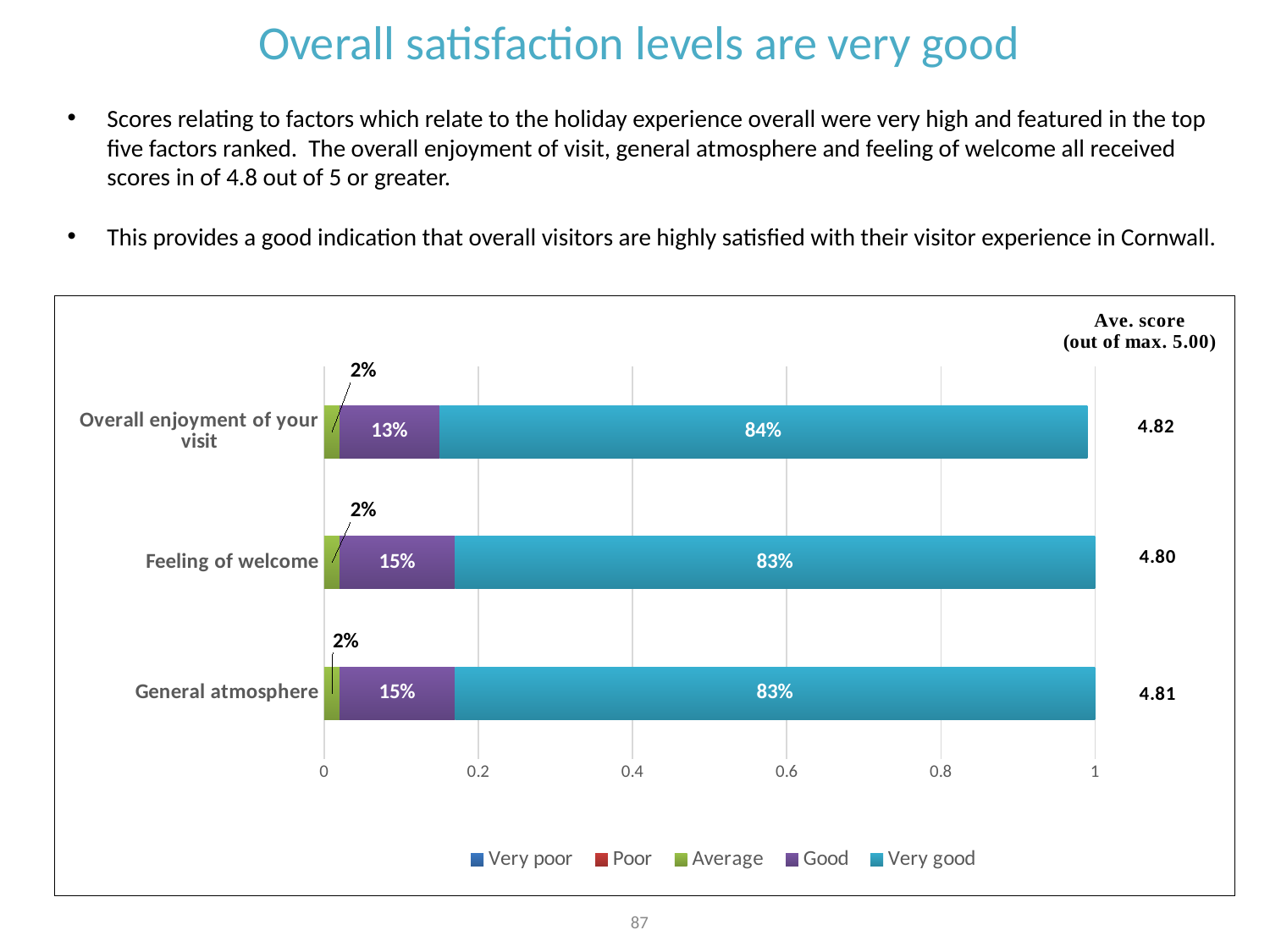
How many series does the legend list? 5 For 'Overall enjoyment of your visit', what is the difference between the Very good and Good percentages? 71 percentage points What percentage of visitors rated 'Feeling of welcome' as Good? 15% What percentage of visitors rated 'Overall enjoyment of your visit' as Very good? 84% Which category has the lowest Good percentage? Overall enjoyment of your visit What percentage of visitors rated 'General atmosphere' as Average? 2% What kind of chart is shown on the slide? Stacked bar chart How many categories are shown on the chart? 3 What is the total of the labelled segments (Average, Good, Very good) for 'Overall enjoyment of your visit'? 99% Which category has the highest Very good percentage? Overall enjoyment of your visit What is the average score (out of 5.00) shown for 'Overall enjoyment of your visit'? 4.82 Which has a larger Good percentage: 'Feeling of welcome' or 'Overall enjoyment of your visit'? Feeling of welcome